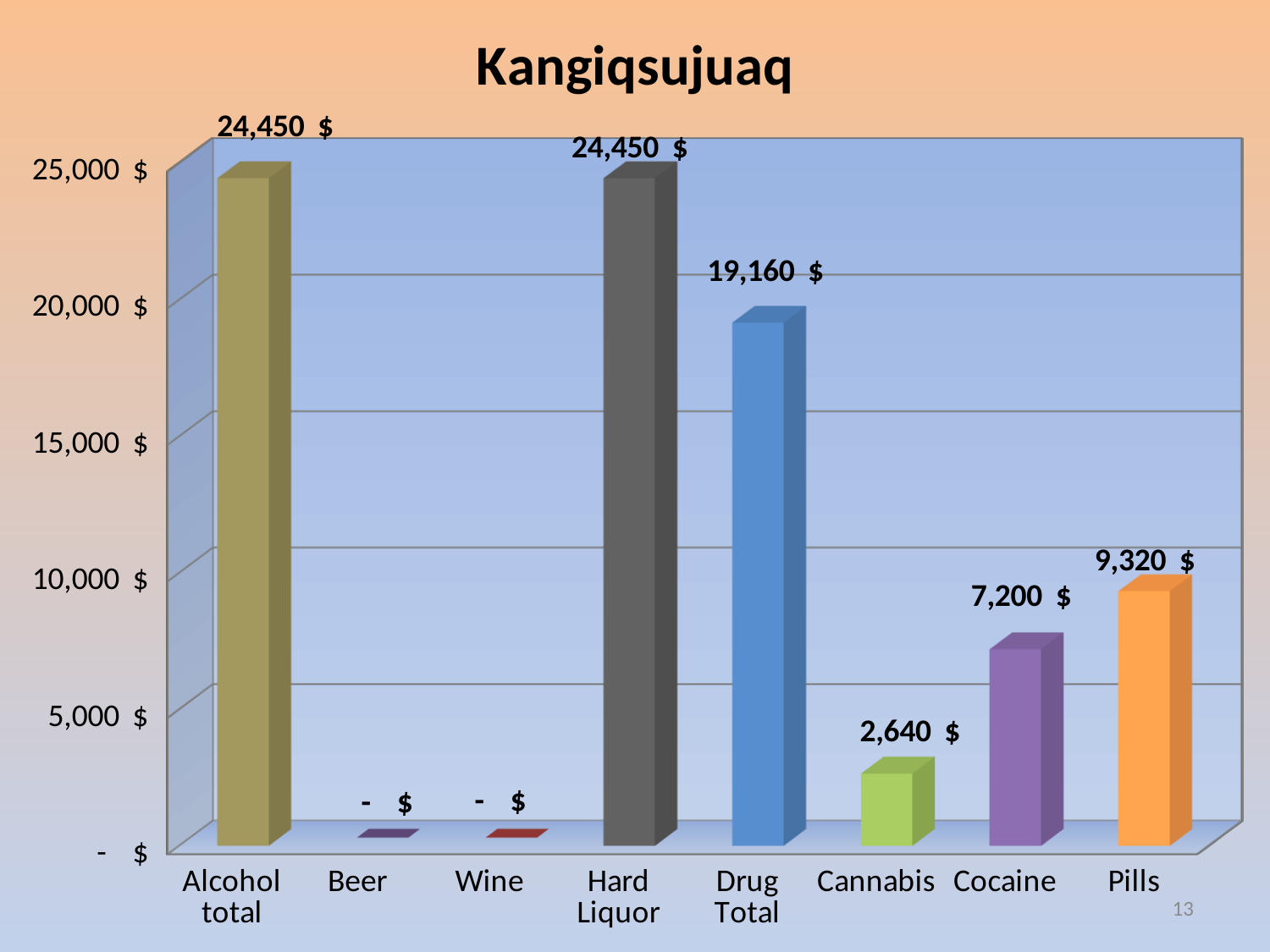
What is the value shown for Cannabis? 2,640 $ What is the value for Pills? 9,320 $ Which is larger, the value for Pills or the value for Cocaine? Pills What is the difference between the Pills and Cannabis values? 6,680 $ What is the value for Cocaine? 7,200 $ Among Cannabis, Cocaine and Pills, which category has the lowest value? Cannabis What is the difference between the Drug Total and Cocaine values? 11,960 $ What is the title of the chart? Kangiqsujuaq What is the value for Hard Liquor? 24,450 $ Is the value for Drug Total greater or less than 15,000 $? greater What is the value for Drug Total? 19,160 $ How many categories are shown on the x axis? 8